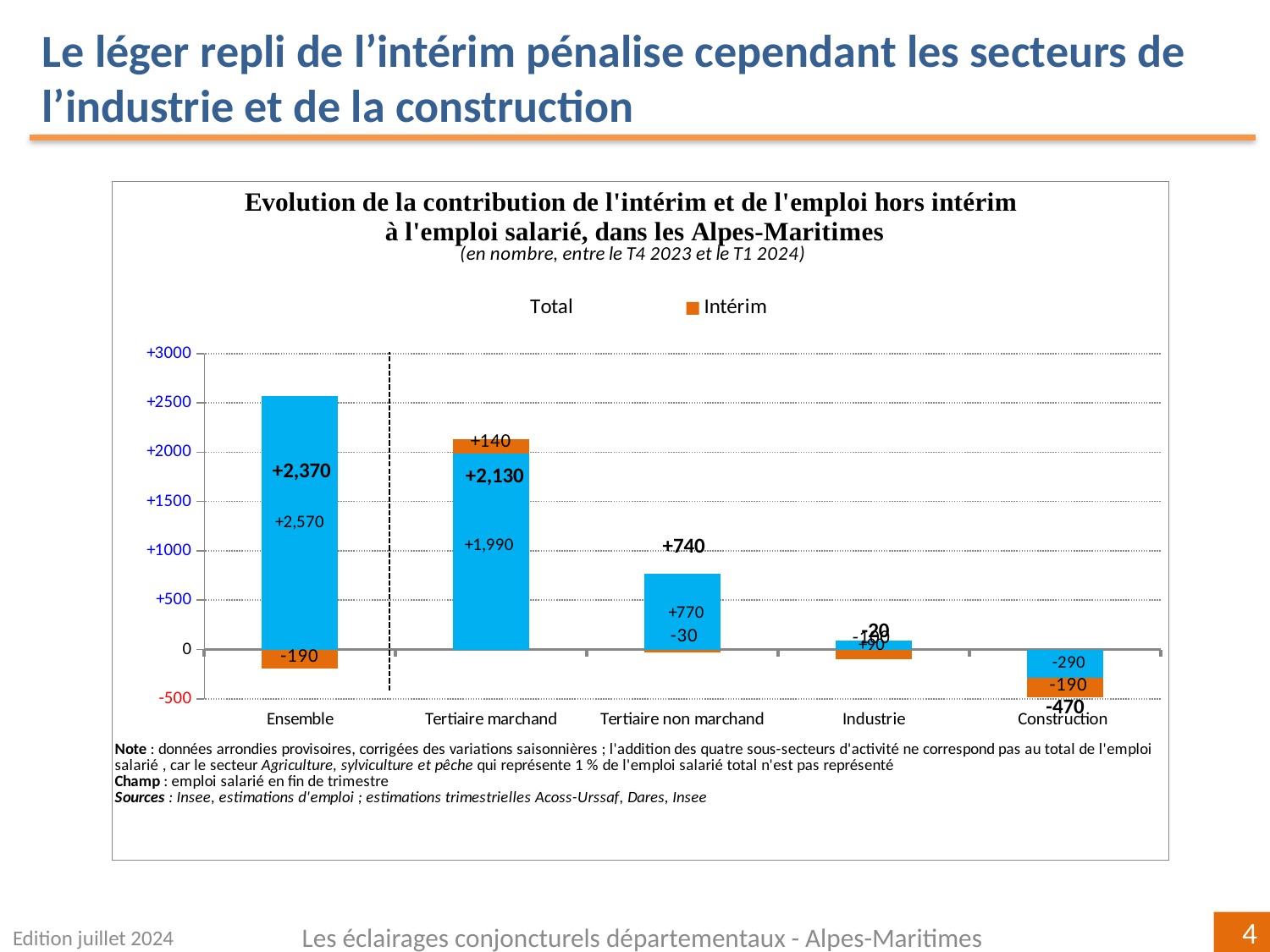
Which category has the lowest total value? Construction What is the Intérim value shown for Tertiaire non marchand? -30 What is the difference between the total value for Ensemble and the total value for Tertiaire marchand? 240 What is the Intérim value shown for Tertiaire marchand? +140 What kind of chart is shown on the slide? bar chart What is the total value (bold label) shown for Tertiaire marchand? +2,130 Which category has the highest total value? Ensemble How many sector categories are shown on the x axis of the chart? 5 What is the Intérim value shown for Ensemble? -190 What is the total value (bold label) shown for Ensemble? +2,370 Which has the larger Intérim value, Tertiaire marchand or Ensemble? Tertiaire marchand What is the total value (bold label) shown for Construction? -470